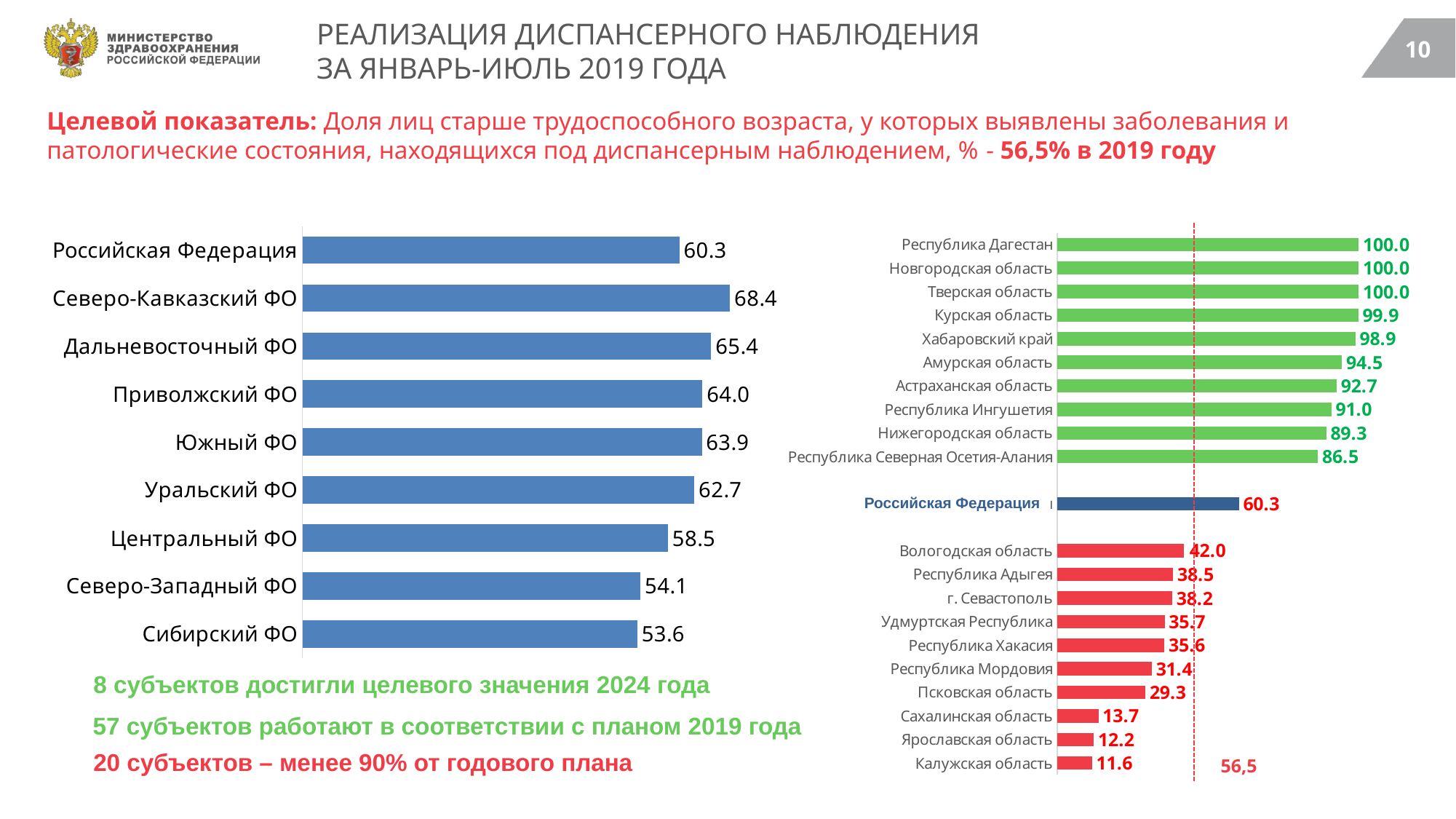
In the right chart, what value does the dashed vertical reference line mark? 56,5 In the left chart, which category has the lowest value? Сибирский ФО In the right chart, what is the value for Хабаровский край? 98.9 In the right chart, what is the difference between the values for Российская Федерация and Калужская область? 48.7 In the left chart, how many bars are plotted? 9 What kind of chart is the left chart? bar chart In the right chart, which is larger: the value for Вологодская область or the value for Республика Адыгея? Вологодская область In the left chart, what is the difference between the values for Северо-Кавказский ФО and Сибирский ФО? 14.8 In the right chart, what is the value for Калужская область? 11.6 In the left chart, what is the value for Северо-Кавказский ФО? 68.4 In the left chart, which category has the highest value? Северо-Кавказский ФО In the left chart, what is the value for Сибирский ФО? 53.6